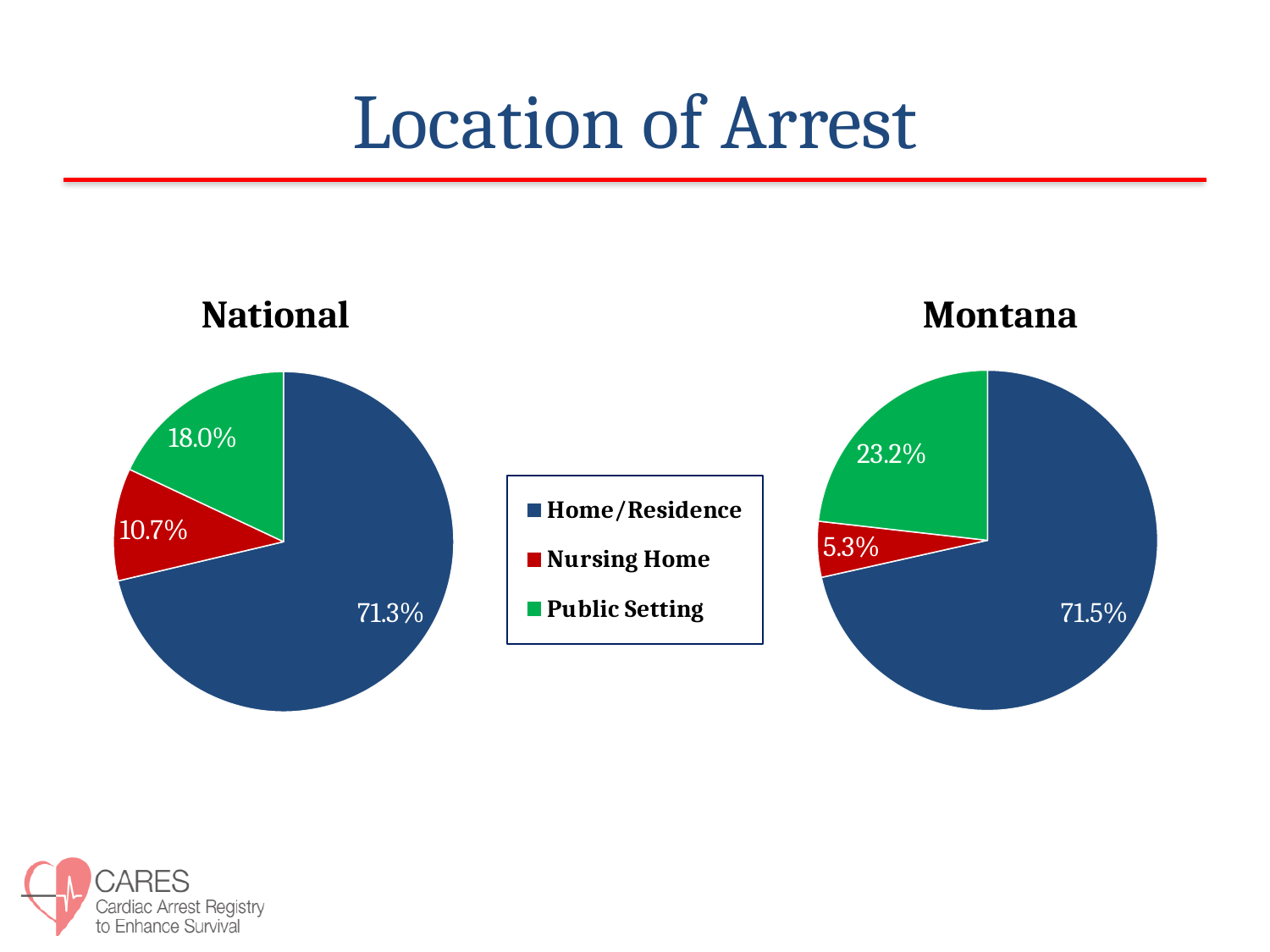
In the Montana pie chart, what share of arrests occurred in a Public Setting? 23.2% What colour represents Public Setting in the pie charts? Green In the Montana pie chart, which location has the largest share? Home/Residence In the National pie chart, which location has the smallest share? Nursing Home How many categories does the legend list? 3 In the National pie chart, what share of arrests occurred in a Nursing Home? 10.7% In the National pie chart, what share of arrests occurred at Home/Residence? 71.3% What kind of chart is used for the National data? Pie chart What is the difference between the Public Setting share in the Montana chart and the Public Setting share in the National chart? 5.2% In the Montana pie chart, what share of arrests occurred in a Nursing Home? 5.3% How many slices does the Montana pie chart have? 3 Which chart shows a larger Nursing Home share, National or Montana? National